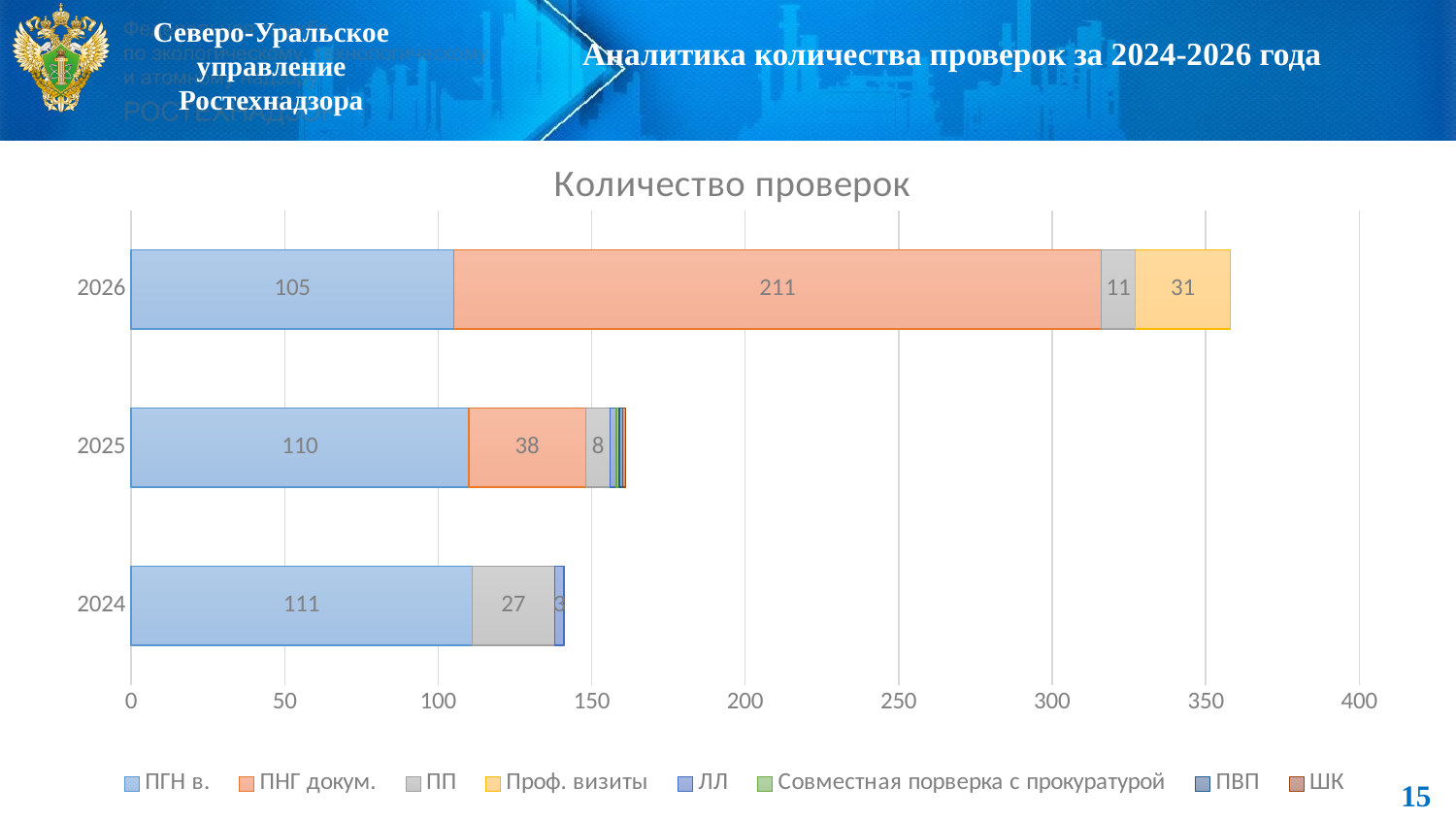
What kind of chart is shown? stacked bar chart What is the value of ПГН в. for 2025? 110 Which year has the larger ПНГ докум. value, 2026 or 2025? 2026 Is the total bar length for 2025 greater or less than 200? less Which year has the longest total bar? 2026 What is the title of the chart? Количество проверок What is the value of ПП for 2024? 27 What is the value of Проф. визиты for 2026? 31 What is the value of ПНГ докум. for 2026? 211 How many series does the legend list? 8 What is the difference between the ПГН в. values for 2024 and 2026? 6 How many years are shown on the chart? 3